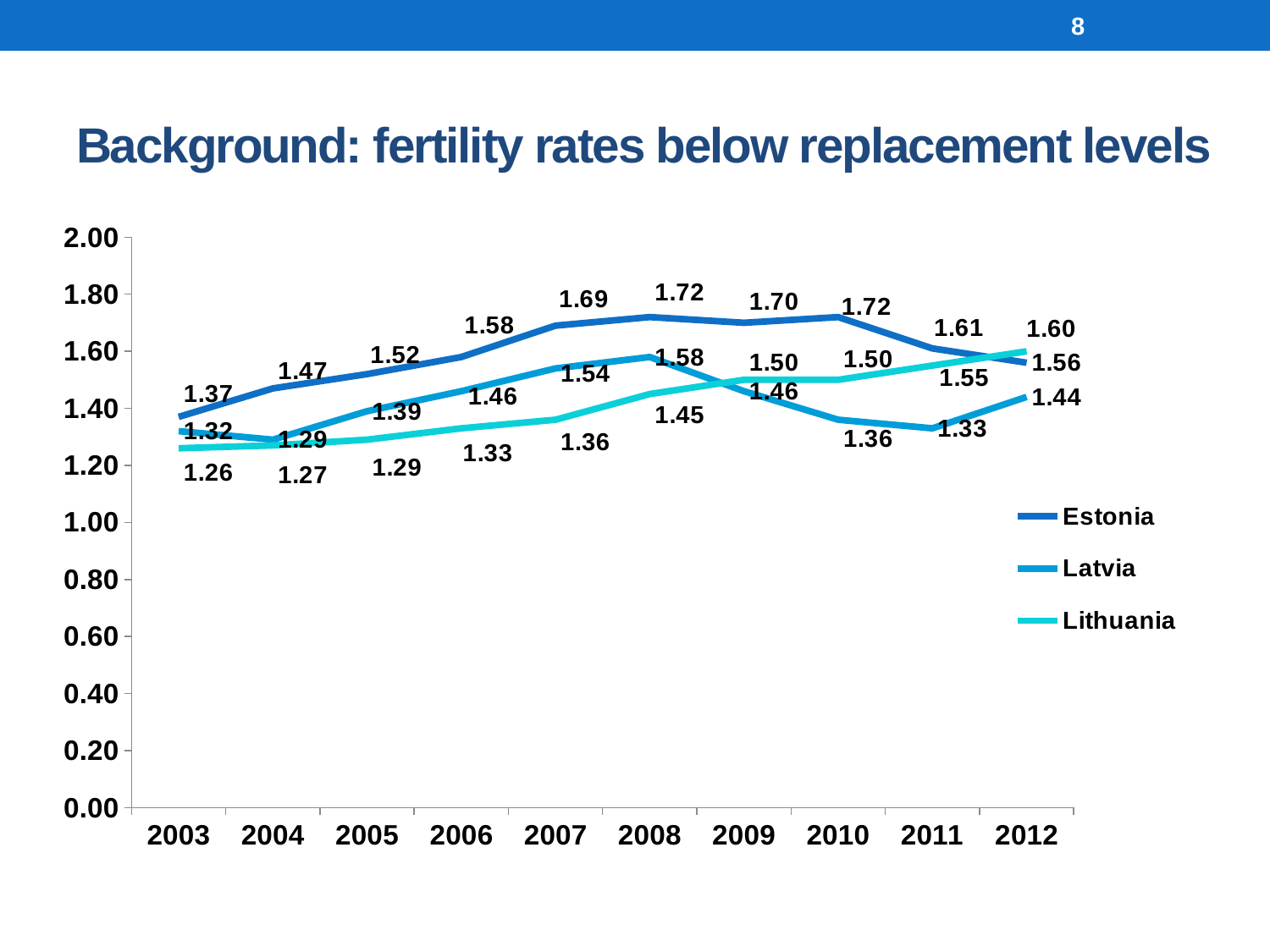
In which year does Lithuania have its lowest fertility rate? 2003 What is the fertility rate for Lithuania in 2012? 1.60 What is the fertility rate for Estonia in 2008? 1.72 Which country has the higher fertility rate in 2012, Estonia or Latvia? Estonia Does Lithuania's fertility rate rise or fall from 2003 to 2012? Rise How many years are shown on the x axis? 10 What is the title of the slide? Background: fertility rates below replacement levels How many series does the legend list? 3 In which year does Latvia have its highest fertility rate? 2008 What is the fertility rate for Latvia in 2003? 1.32 What is the difference between Estonia's and Lithuania's fertility rates in 2007? 0.33 What kind of chart is shown on the slide? Line chart